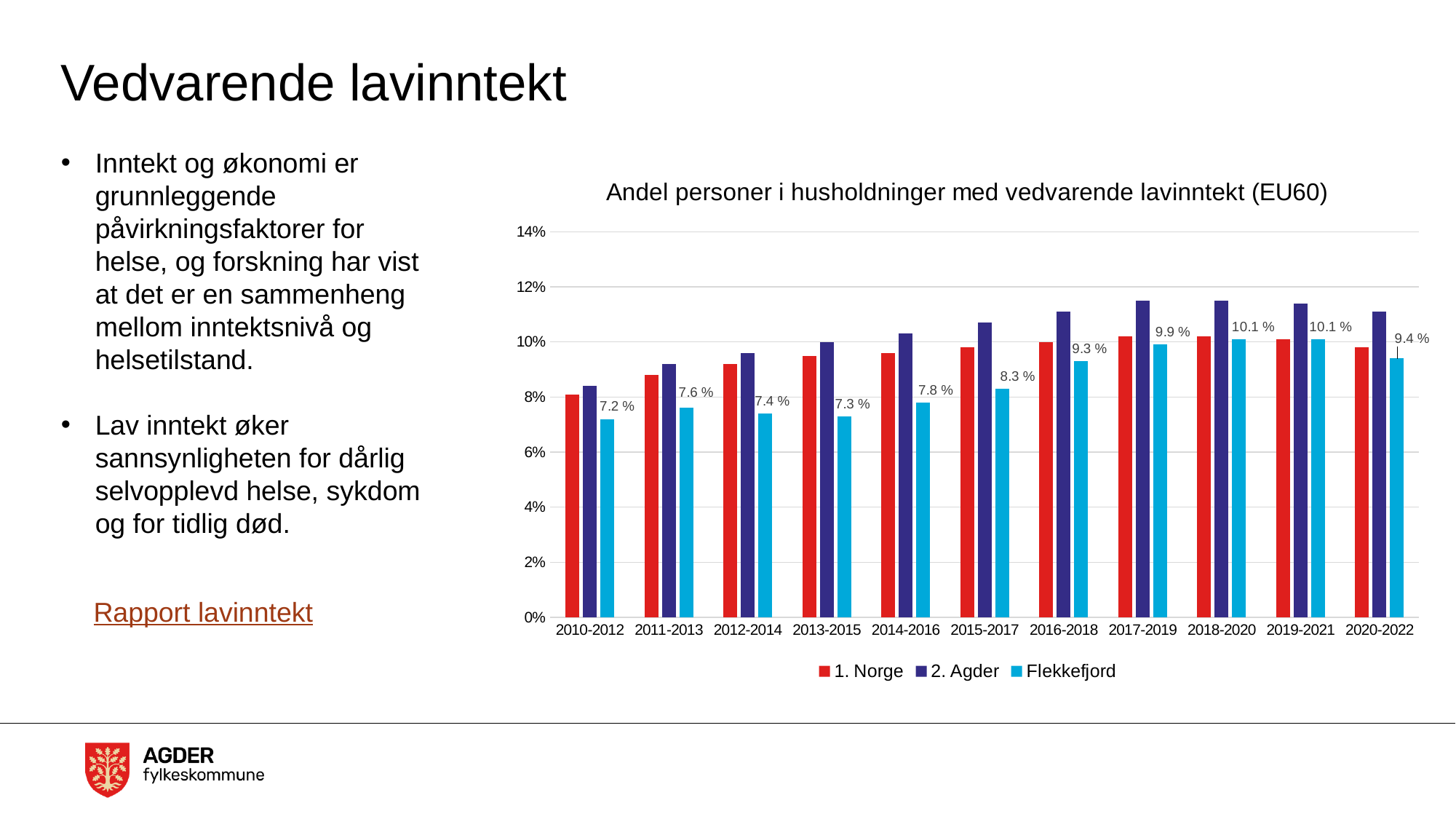
How many series does the legend list? 3 What is the value for Flekkefjord in 2010-2012? 7.2 % Does the value for 2. Agder rise or fall from 2010-2012 to 2017-2019? Rise Is the value for 1. Norge in 2010-2012 greater or less than 10%? less What is the value for Flekkefjord in 2020-2022? 9.4 % In which period is the Flekkefjord value lowest? 2010-2012 Is the value for 2. Agder in 2017-2019 greater or less than 10%? greater What kind of chart is shown on the slide? Bar chart In 2015-2017, which is larger: the value for 2. Agder or for Flekkefjord? 2. Agder How many time periods are shown on the x axis? 11 What is the value for Flekkefjord in 2016-2018? 9.3 % What is the difference between the Flekkefjord values for 2017-2019 and 2010-2012? 2.7 percentage points